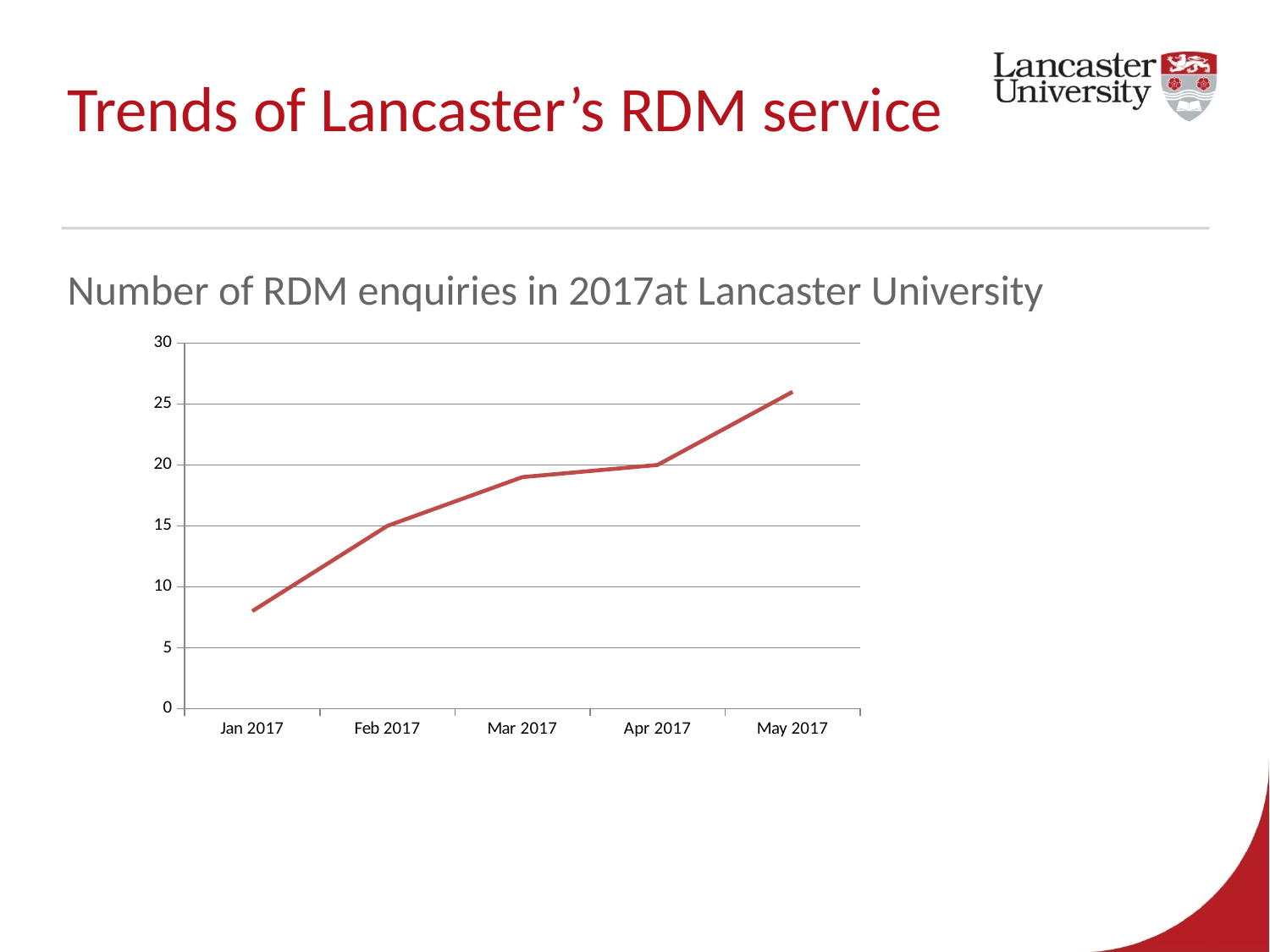
What kind of chart is shown on the slide? line chart Is the number of RDM enquiries in May 2017 greater or less than 20? greater Which month has the lowest number of RDM enquiries? Jan 2017 What is the title of the chart? Number of RDM enquiries in 2017at Lancaster University Is the number of RDM enquiries in Jan 2017 greater or less than 10? less What is the number of RDM enquiries in Feb 2017? 15 What is the number of RDM enquiries in Apr 2017? 20 Do the number of RDM enquiries rise or fall from Jan 2017 to May 2017? rise How many months are plotted on the x axis of the chart? 5 What is the difference in RDM enquiries between Apr 2017 and Feb 2017? 5 Which month has more RDM enquiries, Jan 2017 or Mar 2017? Mar 2017 Which month has the highest number of RDM enquiries? May 2017